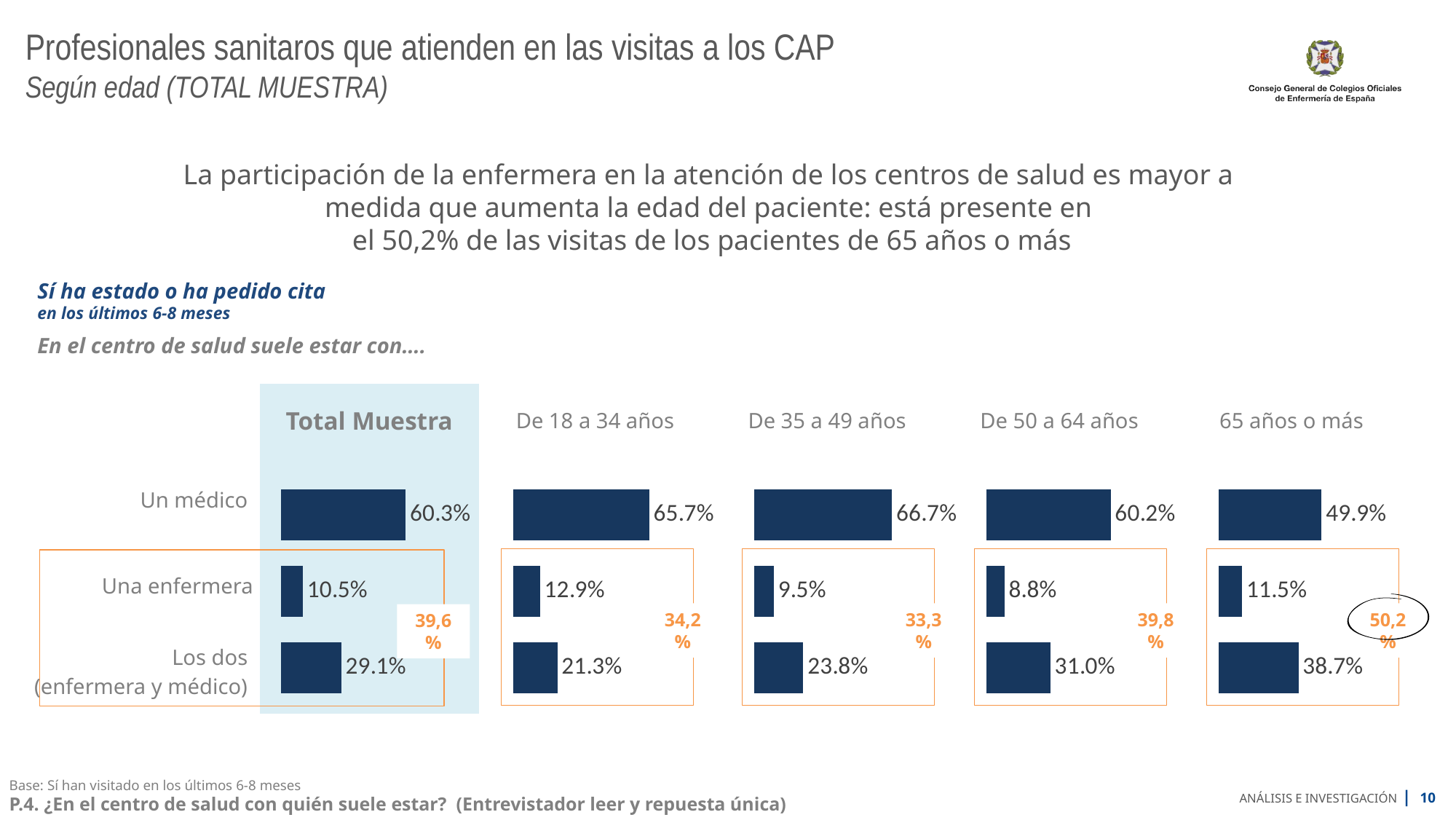
In the '65 años o más' chart, which category has the lowest value? Una enfermera In the 'De 18 a 34 años' chart, which is larger: 'Una enfermera' or 'Los dos (enfermera y médico)'? Los dos (enfermera y médico) In the 'De 35 a 49 años' chart, which category has the highest value? Un médico What kind of chart is used for the 'Total Muestra' data? Bar chart In the 'Total Muestra' chart, what is the value for 'Un médico'? 60.3% In the 'De 50 a 64 años' chart, what is the value for 'Una enfermera'? 8.8% In the 'De 18 a 34 años' chart, what is the value for 'Una enfermera'? 12.9% What orange figure is circled in the '65 años o más' chart? 50,2% In the 'De 50 a 64 años' chart, what is the difference between 'Un médico' and 'Los dos (enfermera y médico)'? 29.2% How many categories does each bar chart on the slide show? 3 In the '65 años o más' chart, what is the value for 'Los dos (enfermera y médico)'? 38.7%